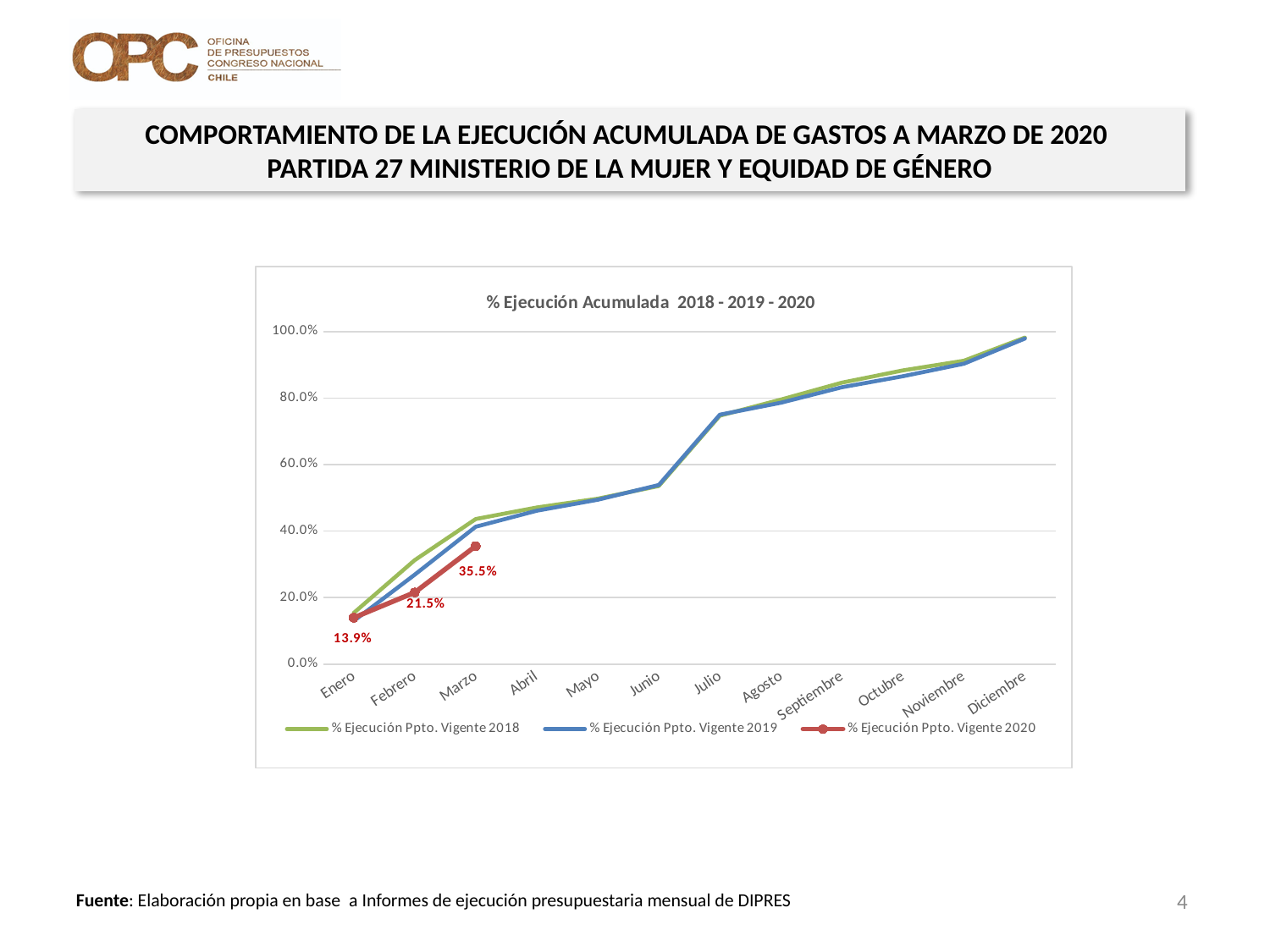
What kind of chart is shown on the slide? Line chart Is the value for Marzo in the % Ejecución Ppto. Vigente 2018 series greater or less than 40.0%? greater For Marzo, which series has the larger value: % Ejecución Ppto. Vigente 2018 or % Ejecución Ppto. Vigente 2020? % Ejecución Ppto. Vigente 2018 Is the value for Julio in the % Ejecución Ppto. Vigente 2019 series greater or less than 60.0%? greater In the % Ejecución Ppto. Vigente 2020 series, what is the difference between the Marzo and Febrero values? 14.0% What is the value for Marzo in the % Ejecución Ppto. Vigente 2020 series? 35.5% In the % Ejecución Ppto. Vigente 2020 series, what is the difference between the Marzo and Enero values? 21.6% How many months are shown on the x axis of the chart? 12 Which month has the highest value in the % Ejecución Ppto. Vigente 2020 series? Marzo What is the value for Enero in the % Ejecución Ppto. Vigente 2020 series? 13.9% What is the value for Febrero in the % Ejecución Ppto. Vigente 2020 series? 21.5% How many series does the chart legend list? 3